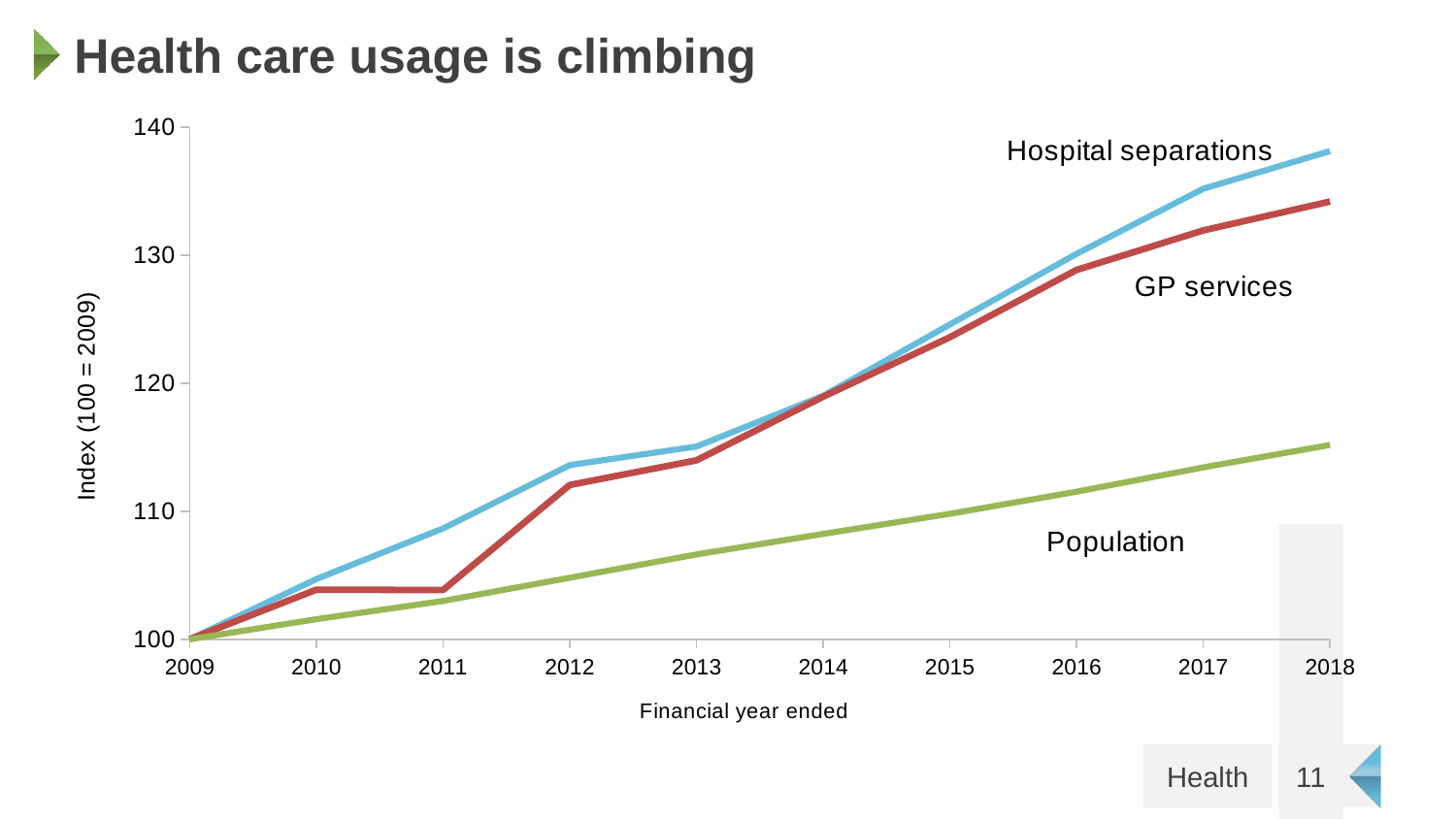
Which series has the lowest value in 2018? Population Is the value for Hospital separations in 2018 greater or less than 130? greater Do the values for GP services rise or fall from 2009 to 2018? rise What is the label on the x axis of the chart? Financial year ended How many years are shown along the x axis? 10 Is the value for GP services in 2011 greater or less than 110? less Is the value for Population in 2018 greater or less than 120? less In 2011, which is larger: Hospital separations or GP services? Hospital separations What is the index value for Hospital separations in 2009? 100 Which series has the highest value in 2018? Hospital separations What kind of chart is shown on the slide? line chart How many series are plotted on the chart? 3